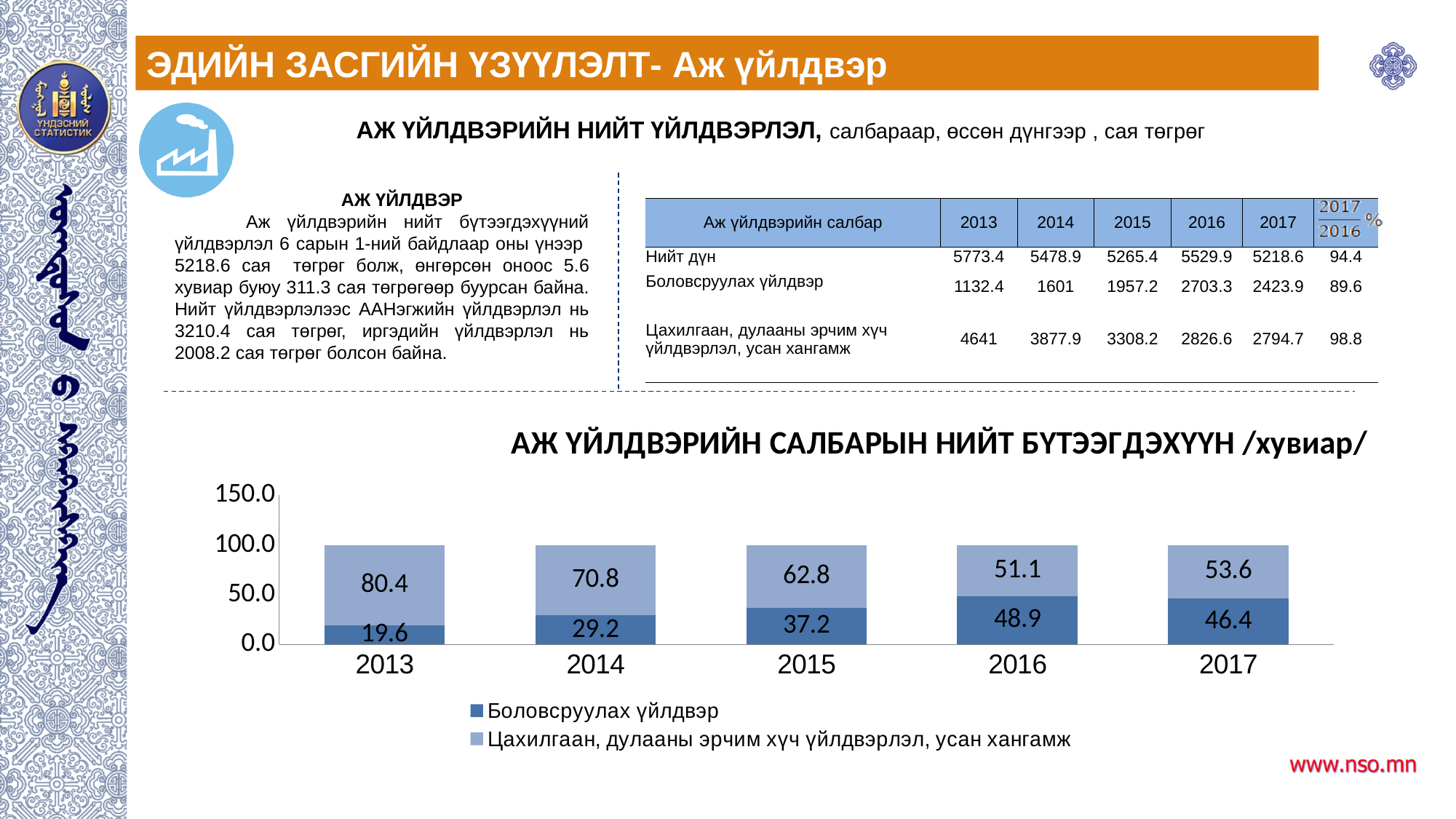
In which year is the value for Цахилгаан, дулааны эрчим хүч үйлдвэрлэл, усан хангамж lowest in the chart? 2016 How many series does the chart's legend list? 2 In which year is the value for Боловсруулах үйлдвэр highest in the chart? 2016 What is the difference between the Цахилгаан, дулааны эрчим хүч үйлдвэрлэл, усан хангамж value and the Боловсруулах үйлдвэр value in 2014? 41.6 What type of chart is shown under the title "АЖ ҮЙЛДВЭРИЙН САЛБАРЫН НИЙТ БҮТЭЭГДЭХҮҮН /хувиар/"? Stacked bar chart What is the total of the stacked bar for 2015 in the chart? 100.0 In 2017, which series has the larger value: Боловсруулах үйлдвэр or Цахилгаан, дулааны эрчим хүч үйлдвэрлэл, усан хангамж? Цахилгаан, дулааны эрчим хүч үйлдвэрлэл, усан хангамж Does the value for Боловсруулах үйлдвэр rise or fall from 2013 to 2016 in the chart? Rise How many years are shown on the x axis of the chart? 5 In the chart, what is the value for Цахилгаан, дулааны эрчим хүч үйлдвэрлэл, усан хангамж in 2015? 62.8 In the chart, what is the value for Боловсруулах үйлдвэр in 2013? 19.6 In the chart, what is the value for Боловсруулах үйлдвэр in 2017? 46.4